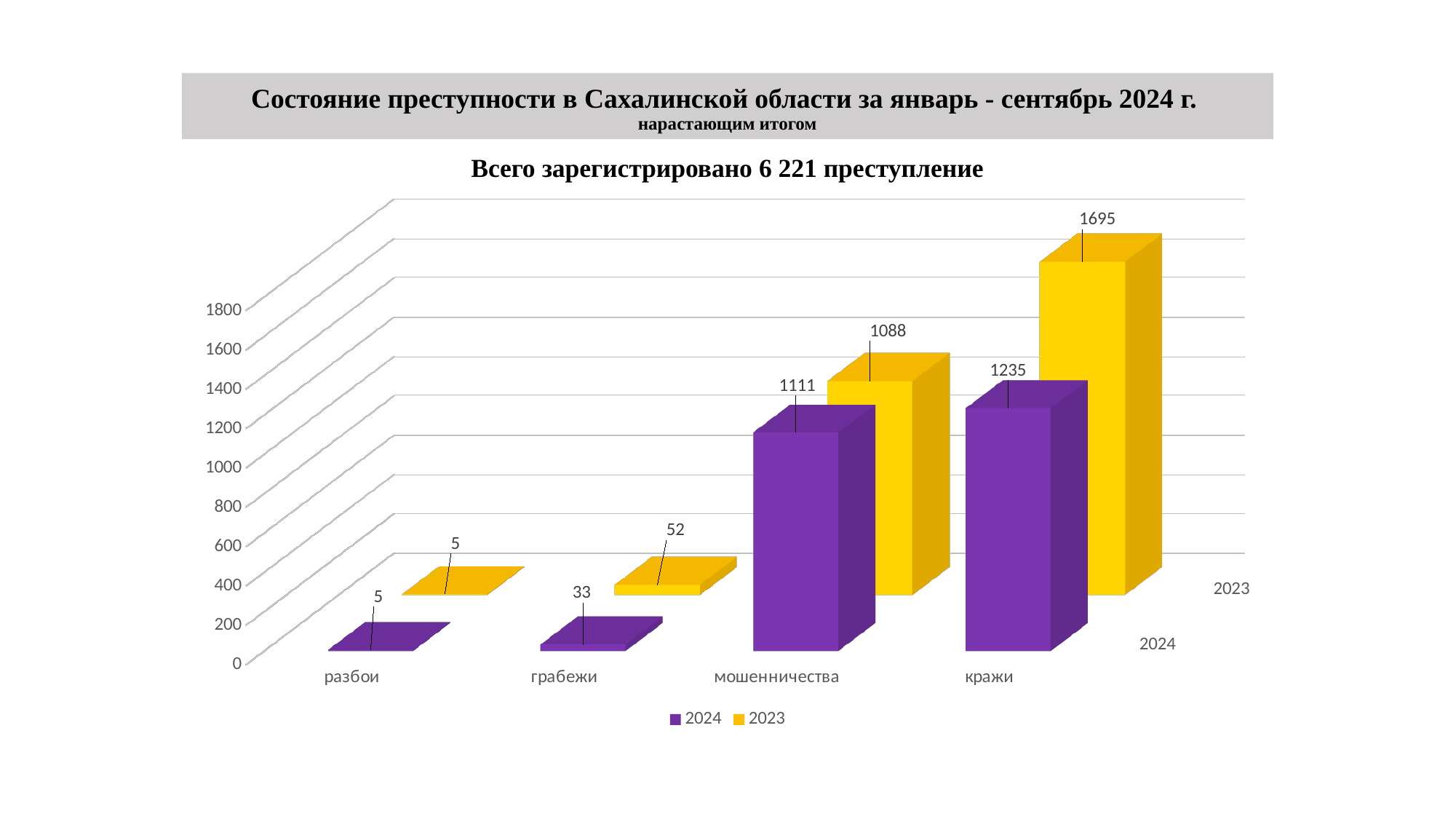
What is the difference between the 2023 and 2024 values for кражи? 460 How many categories are shown on the x axis? 4 Which category has the highest value in the 2024 series? кражи How many series does the legend list? 2 Which category has the lowest value in the 2023 series? разбои Which is larger for мошенничества: the 2024 value or the 2023 value? 2024 What is the value for кражи in the 2023 series? 1695 Which colour represents the 2023 series? yellow What kind of chart is shown on the slide? bar chart What is the value for разбои in the 2023 series? 5 What is the value for грабежи in the 2024 series? 33 What is the value for мошенничества in the 2024 series? 1111